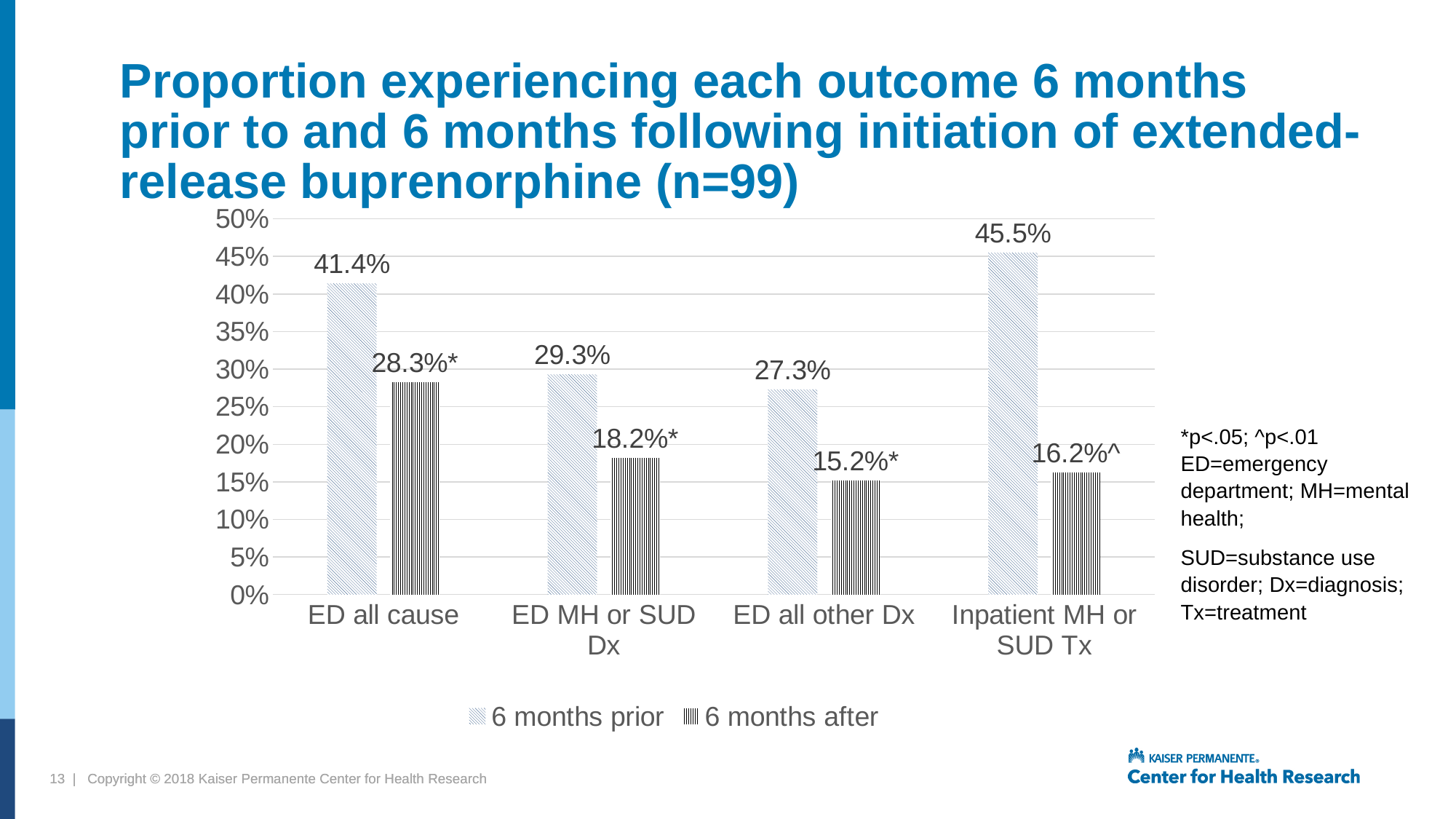
What is the value for "6 months after" for ED all other Dx? 15.2% Which category has the lowest "6 months after" value? ED all other Dx How many categories are shown on the x axis? 4 How many series does the legend list? 2 What is the difference between the "6 months prior" and "6 months after" values for Inpatient MH or SUD Tx? 29.3% What kind of chart is shown on the slide? Bar chart What is the value for "6 months prior" for ED all cause? 41.4% Which is larger for ED all cause: the "6 months prior" value or the "6 months after" value? 6 months prior What are the two series named in the legend? 6 months prior and 6 months after What is the value for "6 months prior" for Inpatient MH or SUD Tx? 45.5% Which category has the highest "6 months prior" value? Inpatient MH or SUD Tx What is the value for "6 months after" for ED MH or SUD Dx? 18.2%